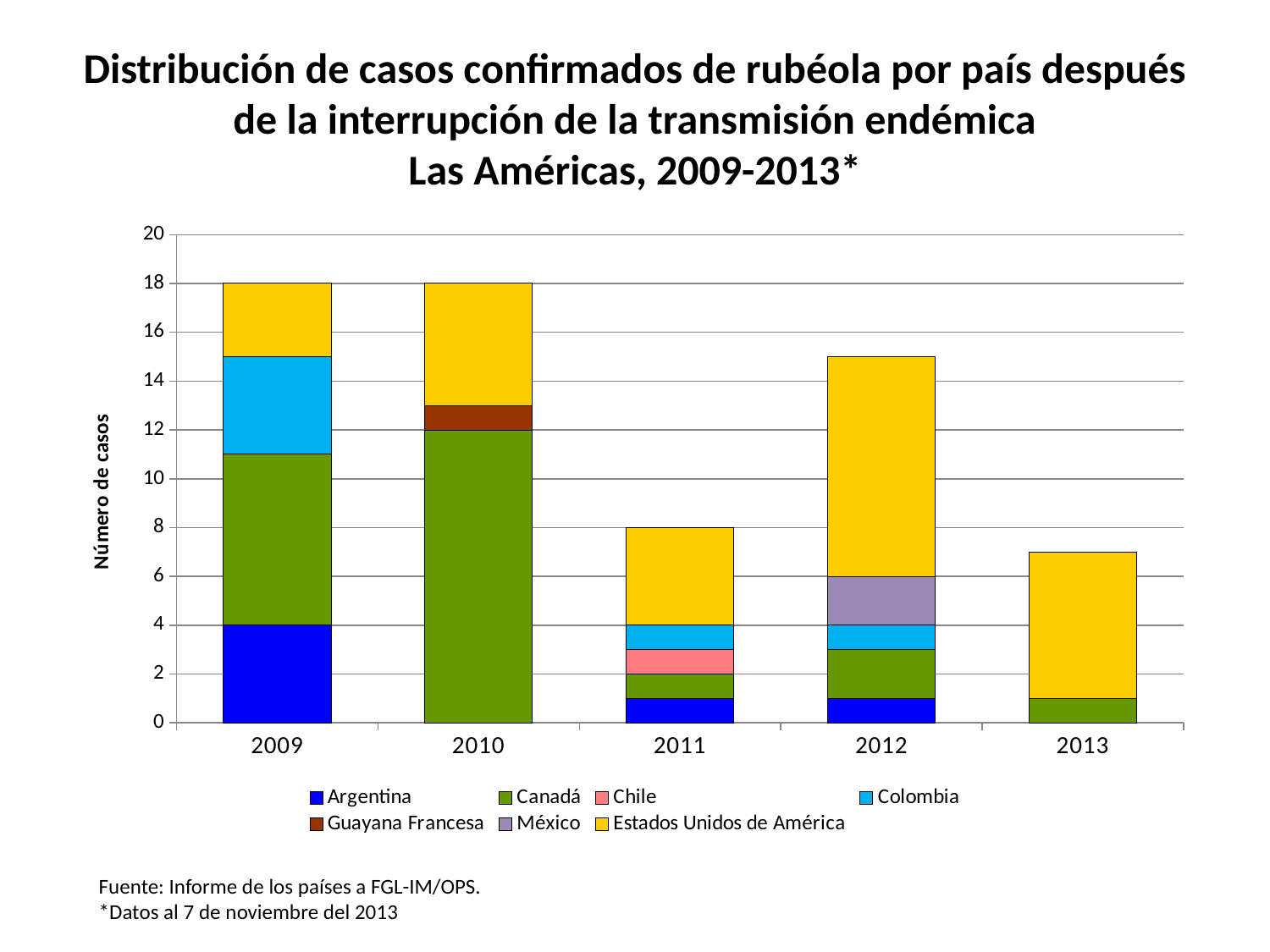
What is the value for Argentina in 2009? 4 How many years are shown on the x axis? 5 Which year has the larger total, 2011 or 2012? 2012 What is the title of the y axis? Número de casos What is the total number of cases for 2009? 18 What is the total number of cases for 2011? 8 How many series does the legend list? 7 What kind of chart is shown on the slide? stacked bar chart What is the total number of cases for 2010? 18 Is the total for 2012 greater or less than 14? greater Which year has the lowest total number of cases? 2013 Is the total for 2013 greater or less than 8? less